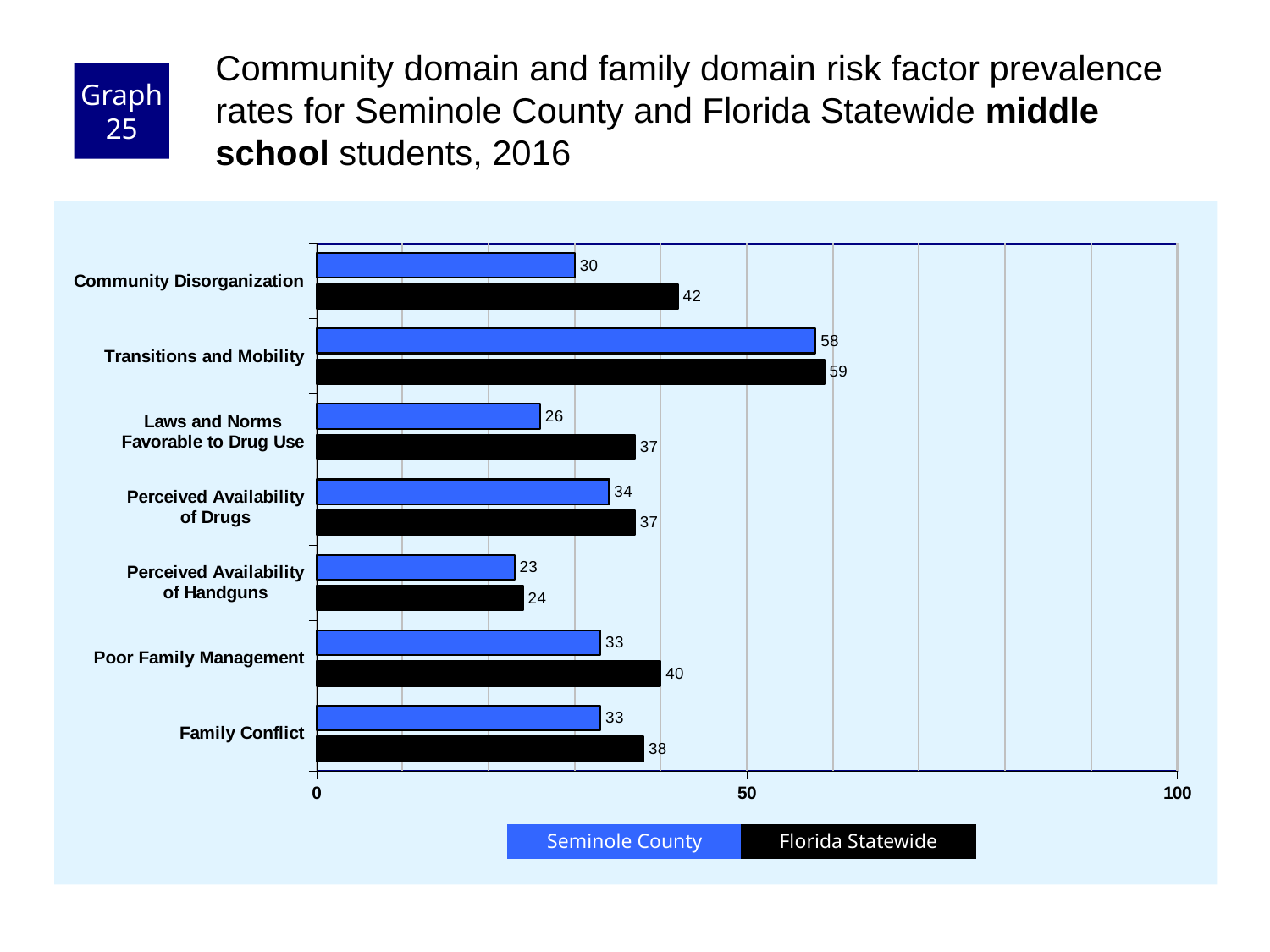
What kind of chart is shown on the slide? bar chart What is the Florida Statewide value for Community Disorganization? 42 Which risk factor has the lowest Seminole County value? Perceived Availability of Handguns Is the Seminole County value for Transitions and Mobility greater or less than 50? greater What is the difference between the Florida Statewide and Seminole County values for Community Disorganization? 12 What is the Seminole County value for Transitions and Mobility? 58 What is the Seminole County value for Perceived Availability of Handguns? 23 Which risk factor has the highest Florida Statewide value? Transitions and Mobility How many series does the legend list? 2 Which is larger for Poor Family Management: the Seminole County value or the Florida Statewide value? Florida Statewide How many risk factor categories are shown on the chart? 7 What is the difference between the Florida Statewide and Seminole County values for Laws and Norms Favorable to Drug Use? 11